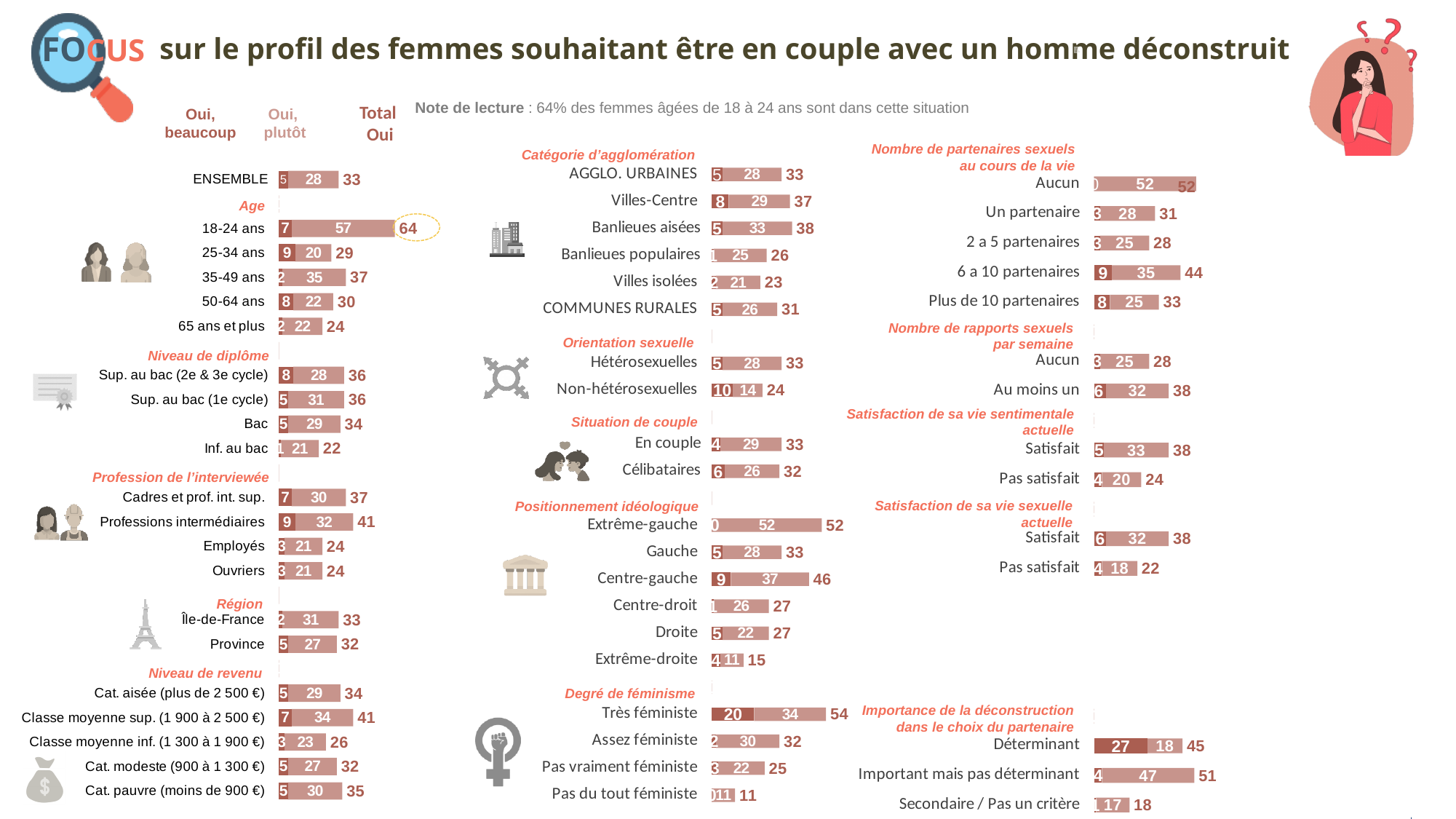
What type of chart is used to show the results on this slide? Stacked bar chart In the Positionnement idéologique chart, which category has the lowest Total Oui? Extrême-droite In the Importance de la déconstruction dans le choix du partenaire chart, what is the Total Oui for Déterminant? 45 In the Profession de l'interviewée chart, what is the difference in Total Oui between Professions intermédiaires and Employés? 17 In the Orientation sexuelle chart, what is the 'Oui, plutôt' value for Non-hétérosexuelles? 14 In the Niveau de revenu chart, what is the Total Oui for Classe moyenne sup. (1 900 à 2 500 €)? 41 How many series are shown in the legend at the top of the slide (excluding the total)? 2 How many categories are shown in the Nombre de partenaires sexuels au cours de la vie chart? 5 In the Age chart, what is the Total Oui value for 18-24 ans? 64 In the Degré de féminisme chart, what is the 'Oui, beaucoup' value for Très féministe? 20 In the Catégorie d'agglomération chart, which has a larger Total Oui: Banlieues aisées or Villes isolées? Banlieues aisées In the Age chart, which age group has the highest Total Oui? 18-24 ans